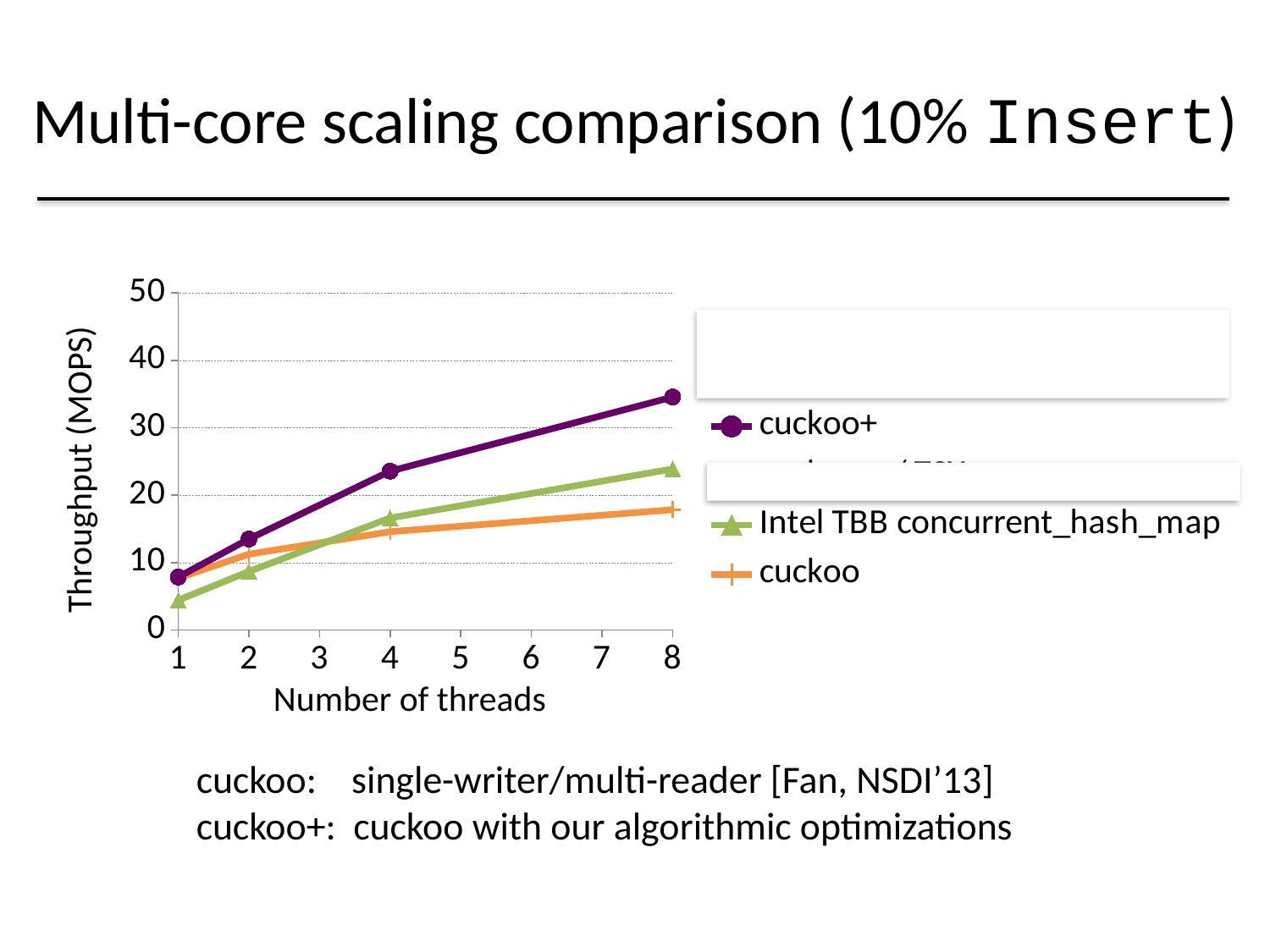
Is the throughput of cuckoo at 8 threads greater or less than 20 MOPS? less Which series has the lowest throughput at 8 threads? cuckoo Does the throughput of cuckoo+ rise or fall as the number of threads increases? rise Is the throughput of cuckoo+ at 8 threads greater or less than 30 MOPS? greater What kind of chart is shown on the slide? line chart At 2 threads, which has higher throughput: cuckoo or Intel TBB concurrent_hash_map? cuckoo Is the throughput of Intel TBB concurrent_hash_map at 1 thread greater or less than 10 MOPS? less Which series has the highest throughput at 8 threads? cuckoo+ At 8 threads, which has higher throughput: cuckoo+ or cuckoo? cuckoo+ What is the label of the y axis? Throughput (MOPS)